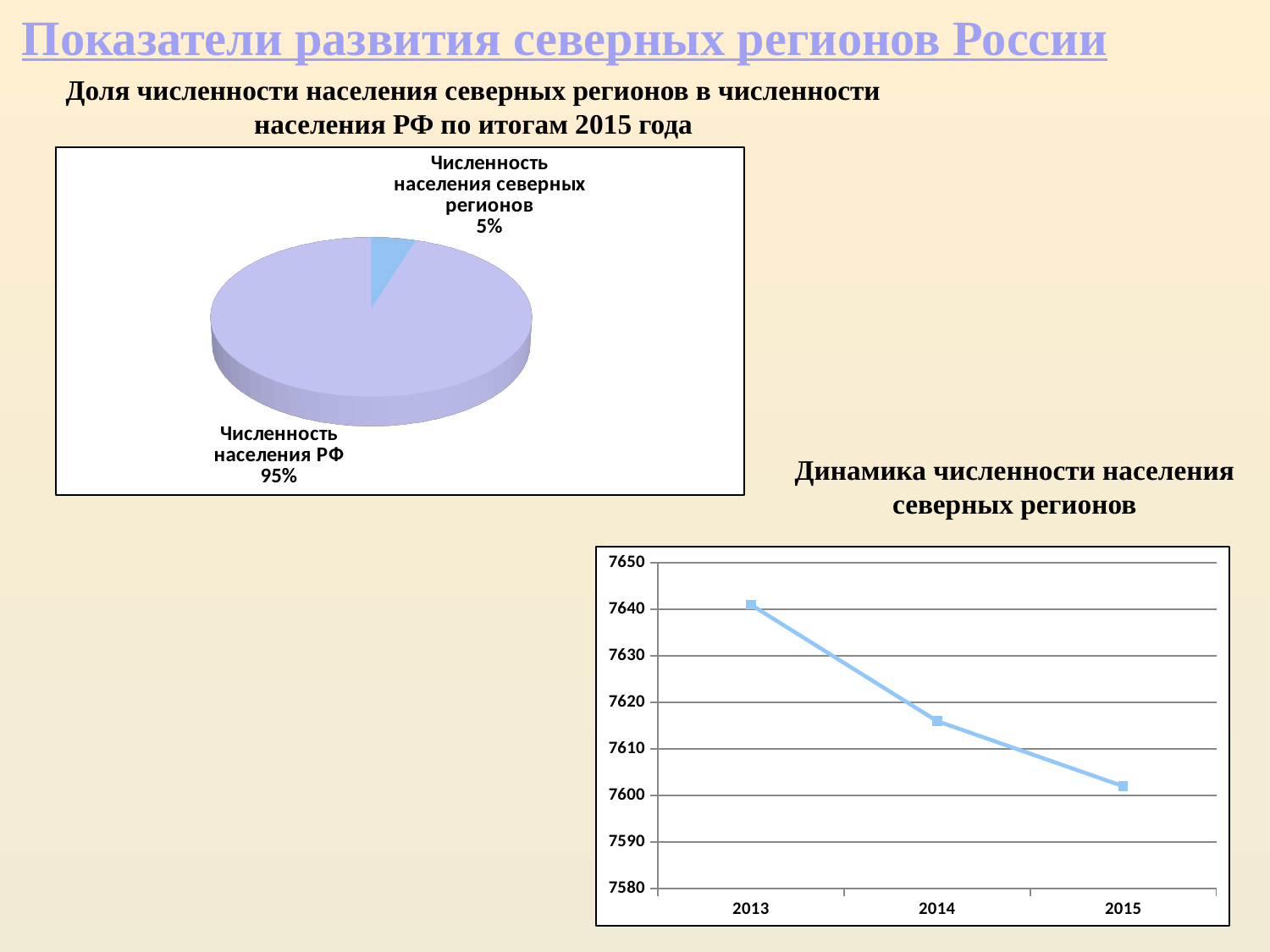
How many years are plotted on the chart 'Динамика численности населения северных регионов'? 3 On the chart 'Динамика численности населения северных регионов', which year has the lowest value? 2015 On the pie chart on the left, what share does 'Численность населения РФ' represent? 95% On the chart 'Динамика численности населения северных регионов', is the value for 2013 greater or less than 7630? greater What kind of chart is the chart on the left of the slide? Pie chart On the chart 'Динамика численности населения северных регионов', do the values rise or fall from 2013 to 2015? Fall What kind of chart is 'Динамика численности населения северных регионов'? Line chart On the pie chart on the left, which slice is the largest? Численность населения РФ On the pie chart on the left, what share of the population does 'Численность населения северных регионов' represent? 5% On the chart 'Динамика численности населения северных регионов', is the value for 2015 greater or less than 7610? less How many slices does the pie chart on the left have? 2 On the pie chart on the left, what is the difference in percentage points between the 'Численность населения РФ' slice and the 'Численность населения северных регионов' slice? 90 percentage points